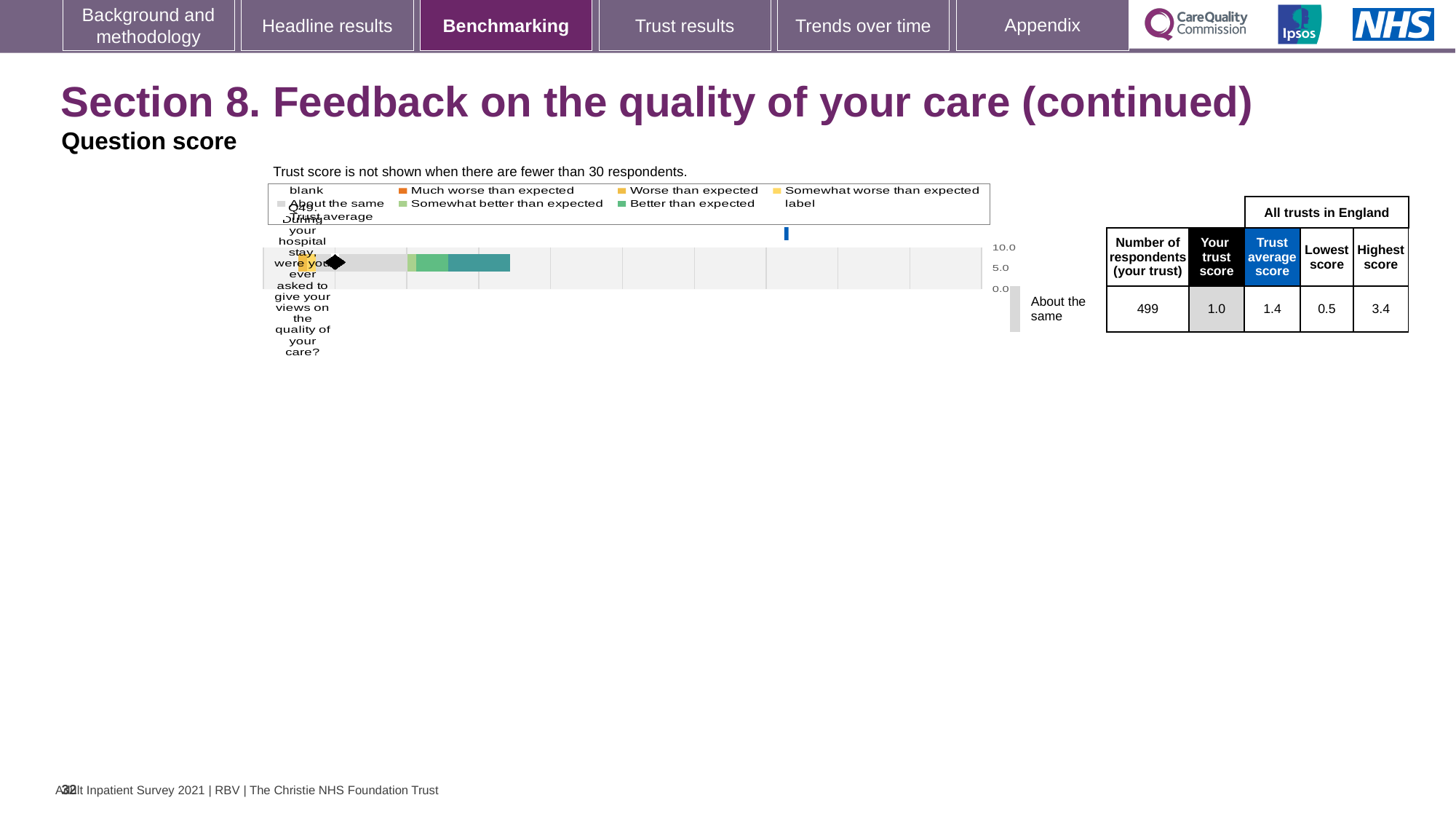
Which survey question is plotted in the benchmarking chart? Q49. During your hospital stay, were you ever asked to give your views on the quality of your care? What is your trust score for Q49? 1.0 Which benchmark category is shown next to the chart for Q49? About the same What colour represents 'Much worse than expected' in the chart legend? Orange What is the trust average score for Q49? 1.4 What is the difference between the trust average score and your trust score for Q49? 0.4 What is the lowest score among all trusts in England for Q49? 0.5 What is the highest score among all trusts in England for Q49? 3.4 What is the difference between the highest and lowest scores for Q49? 2.9 What kind of chart is used to show the benchmarking result for Q49? bar chart Which is larger for Q49, your trust score or the trust average score? Trust average score What is the number of respondents (your trust) for Q49? 499